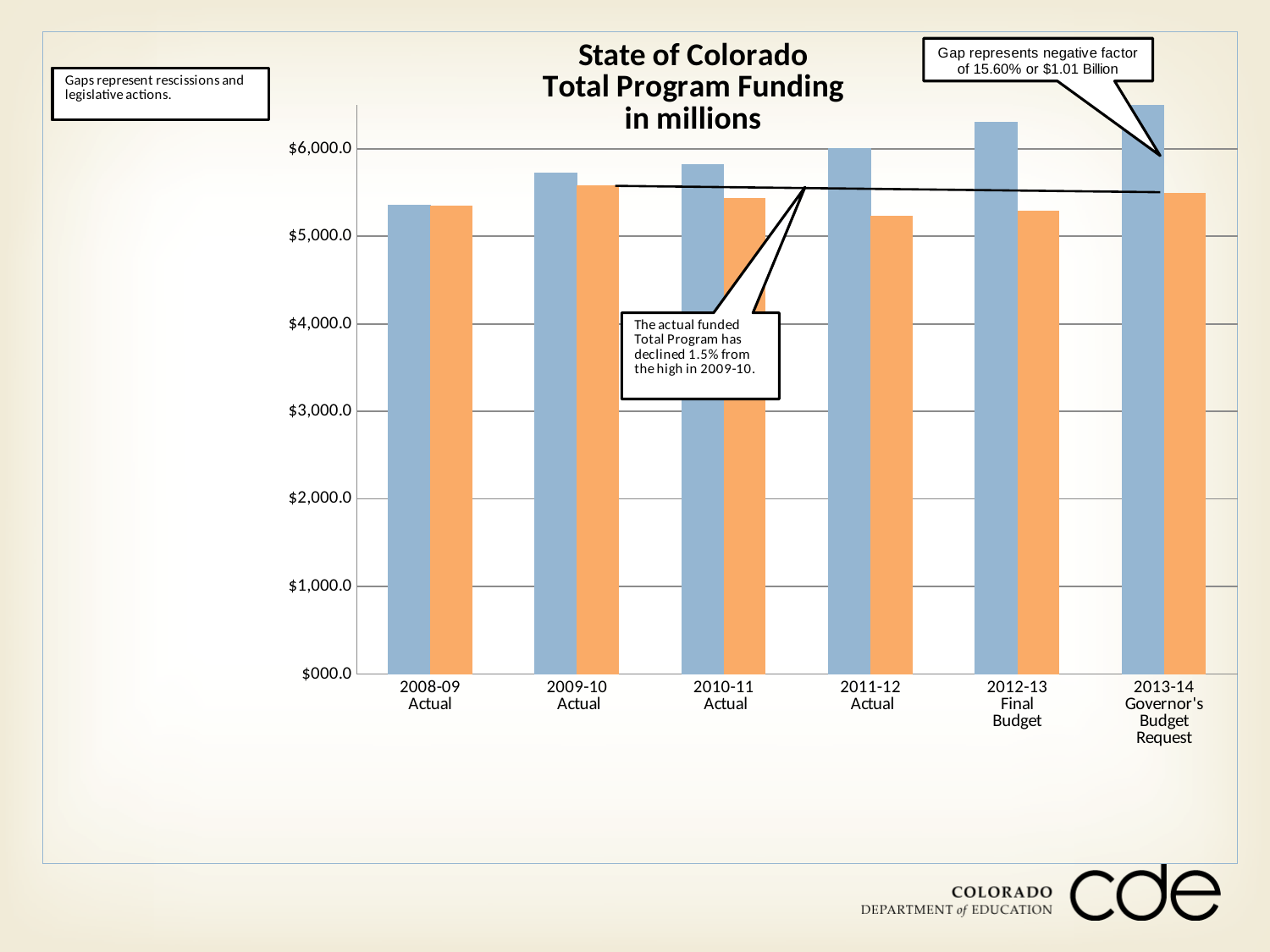
In 2013-14 Governor's Budget Request, which bar is taller, the blue bar or the orange bar? the blue bar How many fiscal-year categories are shown on the x axis? 6 What is the title of the chart? State of Colorado Total Program Funding in millions What kind of chart is shown on the slide? bar chart How many bars are plotted for each fiscal-year category? 2 Is the orange bar for 2011-12 Actual greater or less than $6,000.0? less According to the callout on the chart, what negative factor does the gap for 2013-14 represent? 15.60% or $1.01 Billion Do the blue bars rise or fall from 2008-09 Actual to 2013-14 Governor's Budget Request? rise Is the blue bar for 2012-13 Final Budget greater or less than $6,000.0? greater Which fiscal year has the shortest blue bar? 2008-09 Actual Which fiscal year has the tallest blue bar? 2013-14 Governor's Budget Request Is the blue bar for 2008-09 Actual greater or less than $5,000.0? greater